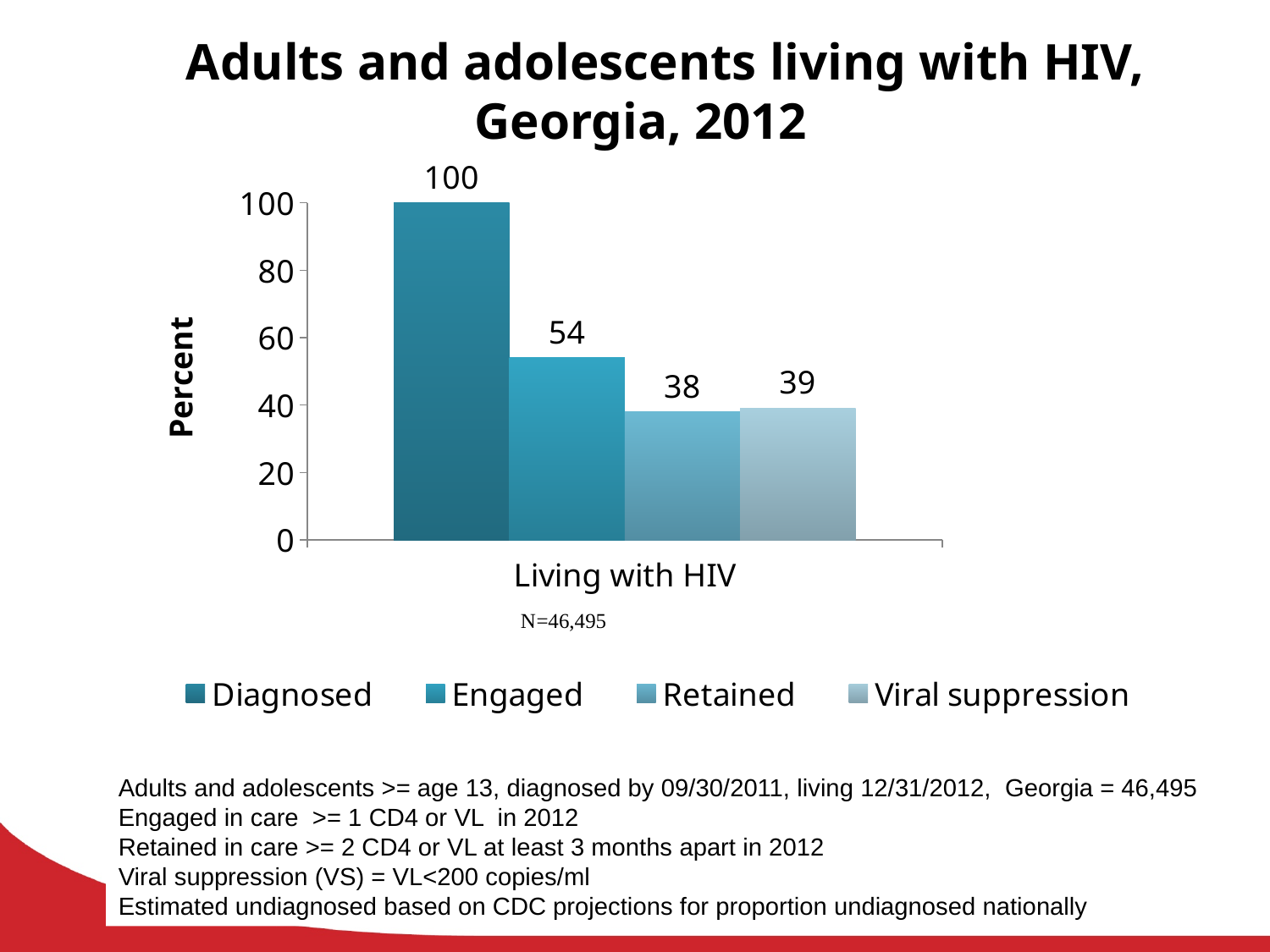
Which series has the highest value? Diagnosed Which is larger, the value for Engaged or the value for Viral suppression? Engaged What is the value for Engaged? 54 What is the value for Viral suppression? 39 What is the label on the vertical axis? Percent What is the difference between the Engaged and Retained values? 16 What is the difference between the Diagnosed and Engaged values? 46 Which series has the lowest value? Retained What is the value for Diagnosed? 100 How many series does the legend list? 4 What is the value for Retained? 38 What kind of chart is shown? Bar chart